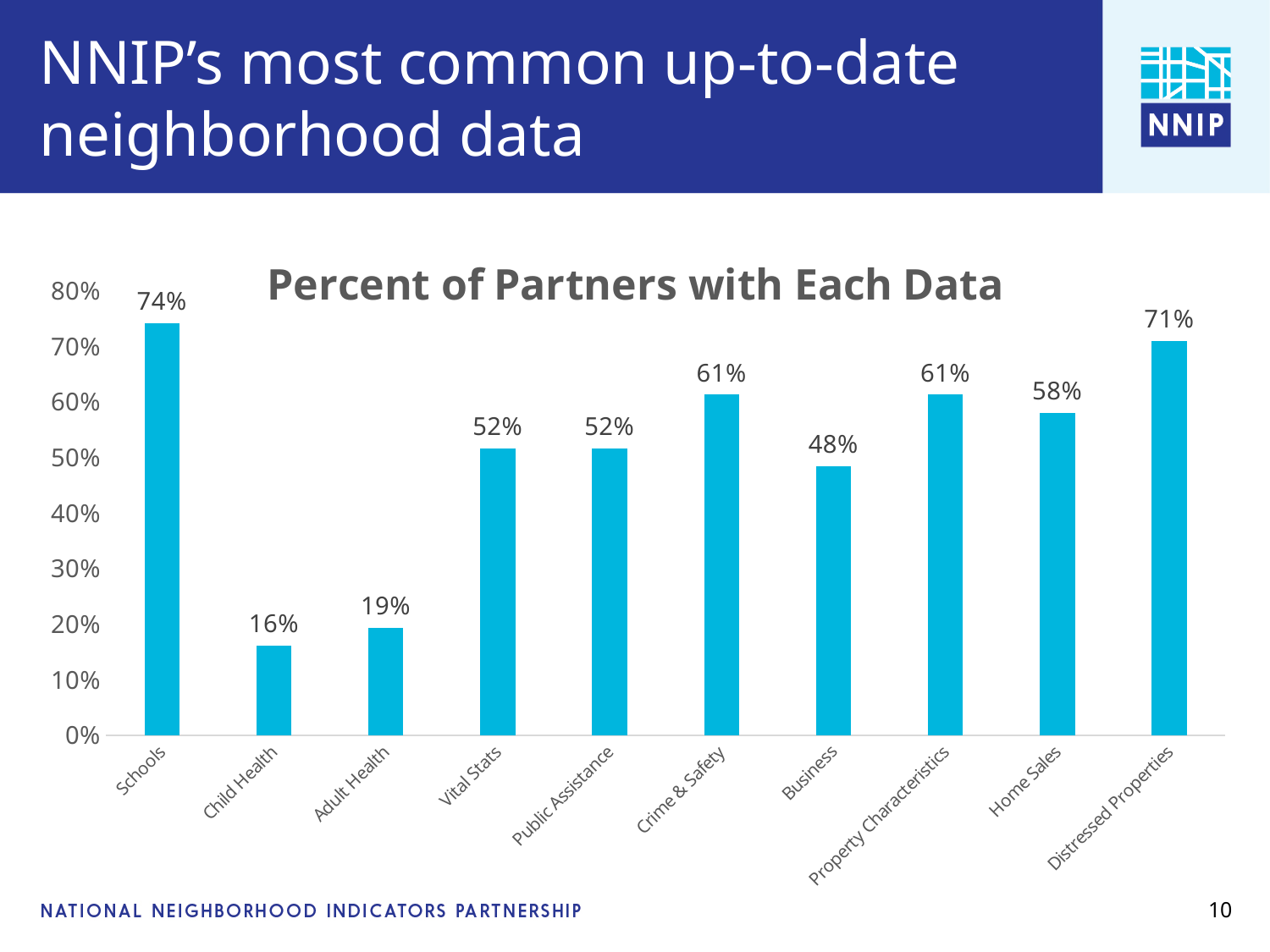
Is the value for Vital Stats greater or less than 40%? greater What is the title of the chart? Percent of Partners with Each Data What is the difference between the values for Schools and Distressed Properties? 3% Which is larger, the value for Crime & Safety or the value for Business? Crime & Safety What percent of partners have Schools data? 74% What is the difference between the values for Business and Adult Health? 29% What is the value for Child Health? 16% Which category has the highest percent of partners? Schools What percent of partners have Home Sales data? 58% What kind of chart is shown on the slide? bar chart Which category has the lowest percent of partners? Child Health How many categories are shown on the x axis? 10